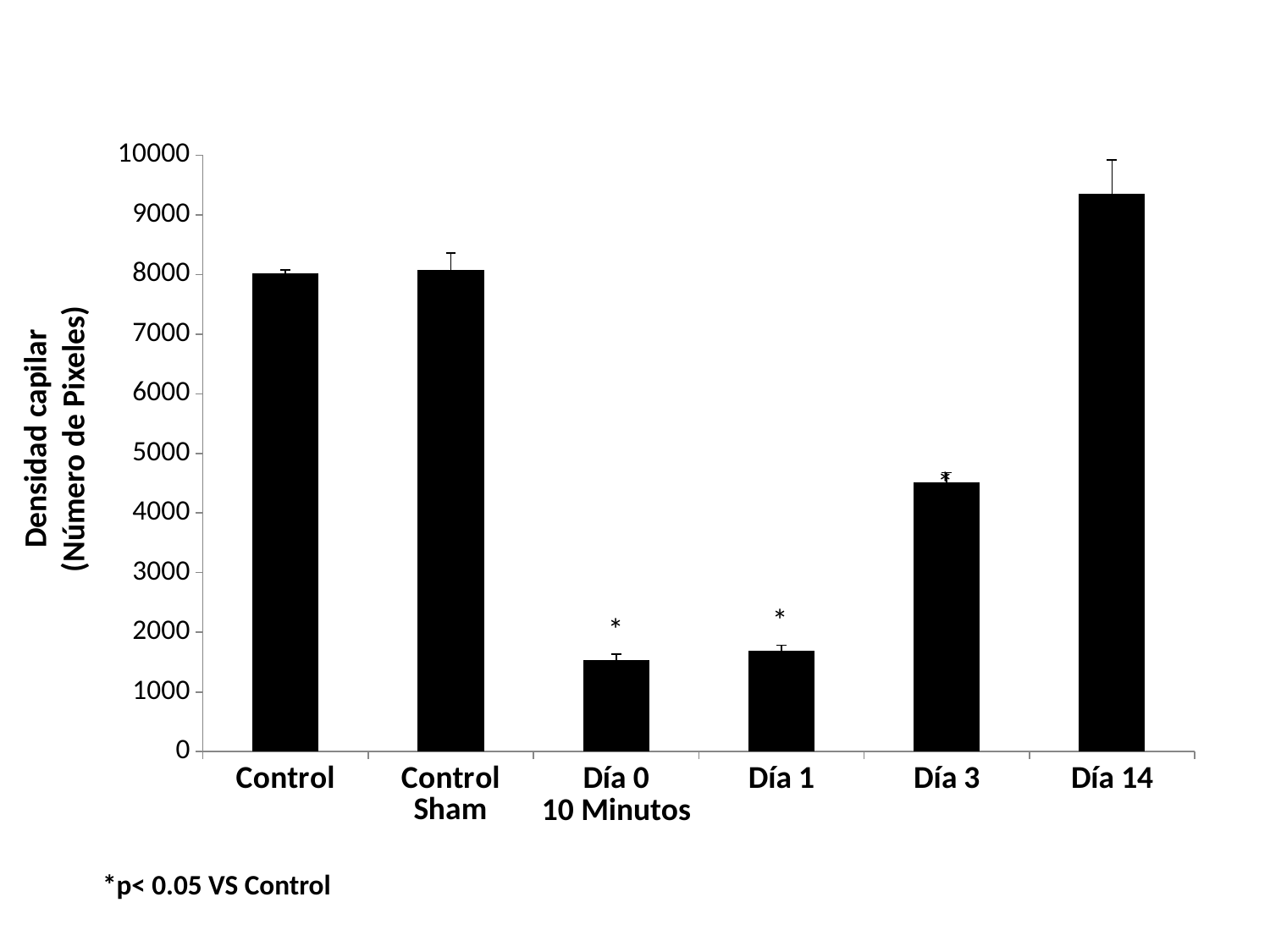
Which category has the highest capillary density? Día 14 What kind of chart is shown on the slide? bar chart Is the value for Día 3 greater or less than 4000? greater Which is larger, the value for Control or the value for Día 1? Control How many categories are plotted on the x axis? 6 What is the label of the y axis? Densidad capilar (Número de Pixeles) Is the value for Día 3 greater or less than 5000? less Is the value for Día 0 10 Minutos greater or less than 2000? less Which is larger, the value for Día 3 or the value for Día 14? Día 14